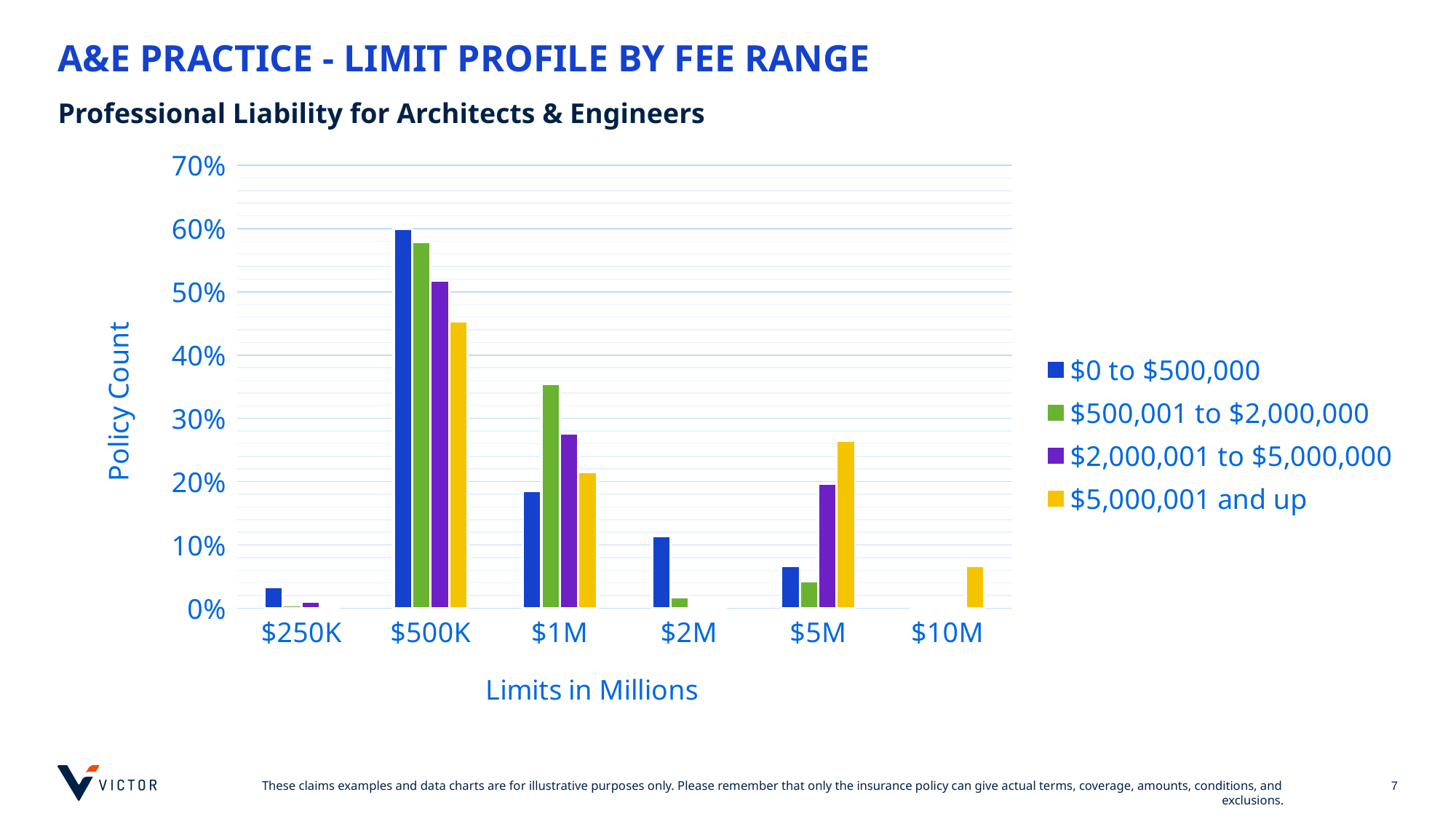
Is the value for the $0 to $500,000 series at $500K greater or less than 50%? greater What is the title of the y axis? Policy Count Is the value for the $5,000,001 and up series at $5M greater or less than 20%? greater Is the value for the $500,001 to $2,000,000 series at $1M greater or less than 30%? greater For the $5,000,001 and up series, which limit category has the highest value? $500K At the $1M limit, which series has the larger value: $500,001 to $2,000,000 or $0 to $500,000? $500,001 to $2,000,000 How many series does the legend list? 4 Which series is the only one with a visible bar at the $10M limit? $5,000,001 and up How many limit categories are shown on the x axis? 6 What kind of chart is shown on the slide? bar chart At the $5M limit, which series has the larger value: $5,000,001 and up or $0 to $500,000? $5,000,001 and up For the $0 to $500,000 series, which limit category has the highest value? $500K